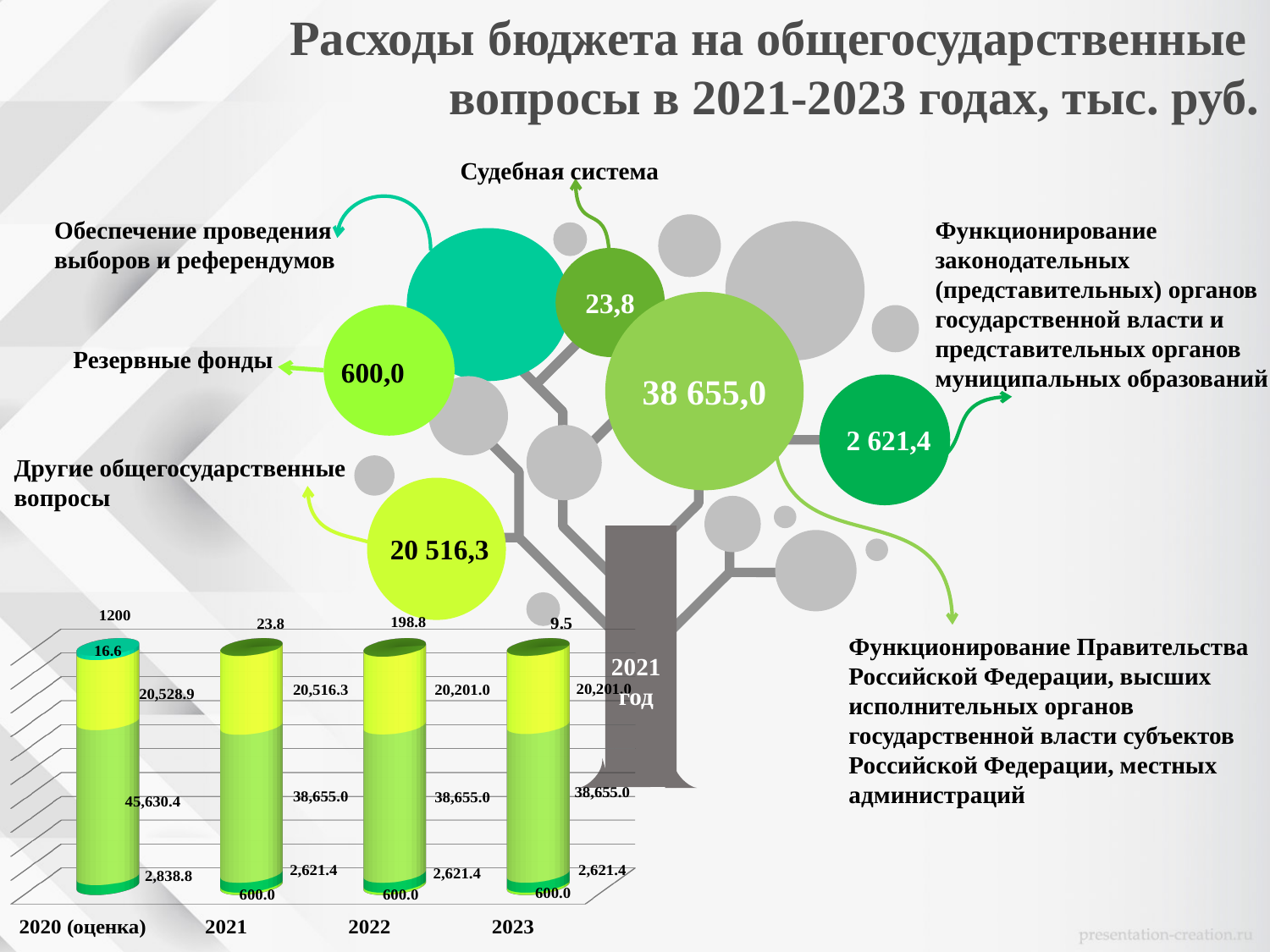
In the bar chart, what value is labelled above the top of the 2022 bar? 198.8 In the bar chart, what is the difference between the largest segment of the 2020 (оценка) bar (45,630.4) and the largest segment of the 2021 bar (38,655.0)? 6,975.4 What kind of chart is shown at the bottom of the slide? Stacked bar chart In the bar chart, what is the value of the largest segment of the 2020 (оценка) bar? 45,630.4 In the bar chart, what value is labelled above the top of the 2020 (оценка) bar? 1200 In the bar chart, what is the value of the largest segment of the 2021 bar? 38,655.0 In the bar chart, does the value of the largest segment rise or fall from 2020 (оценка) to 2021? Fall What is the title of the slide containing the chart? Расходы бюджета на общегосударственные вопросы в 2021-2023 годах, тыс. руб. In the bar chart, what is the value of the second-largest segment of the 2022 bar? 20,201.0 In the bar chart, what is the value of the bottom segment of the 2023 bar? 600.0 In the bar chart, which is larger: the 2,838.8 segment of the 2020 (оценка) bar or the 2,621.4 segment of the 2021 bar? 2,838.8 (2020) How many year categories are shown along the x axis of the bar chart? 4